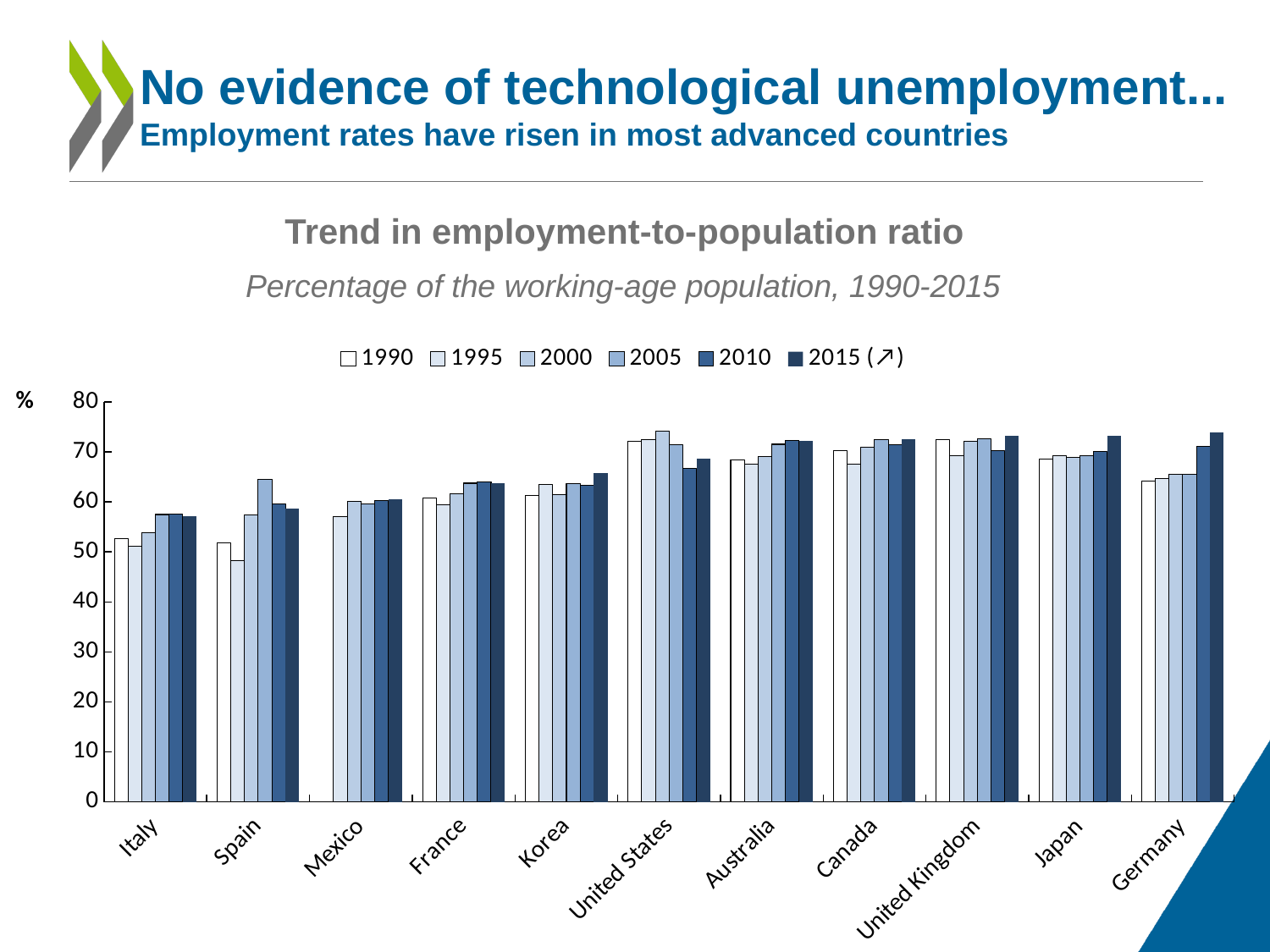
Which country has the lowest 1995 value? Spain How many series does the legend list? 6 Which is larger for Spain: the 1995 value or the 2000 value? 2000 Is the 1995 value for Spain greater or less than 50? less What kind of chart is shown on the slide? bar chart Is the 2010 value for the United States greater or less than 70? less How many countries are shown on the x axis of the chart? 11 What is the title of the chart? Trend in employment-to-population ratio Which country has the larger 2015 value, Germany or Italy? Germany Is the 2015 value for Germany greater or less than 70? greater